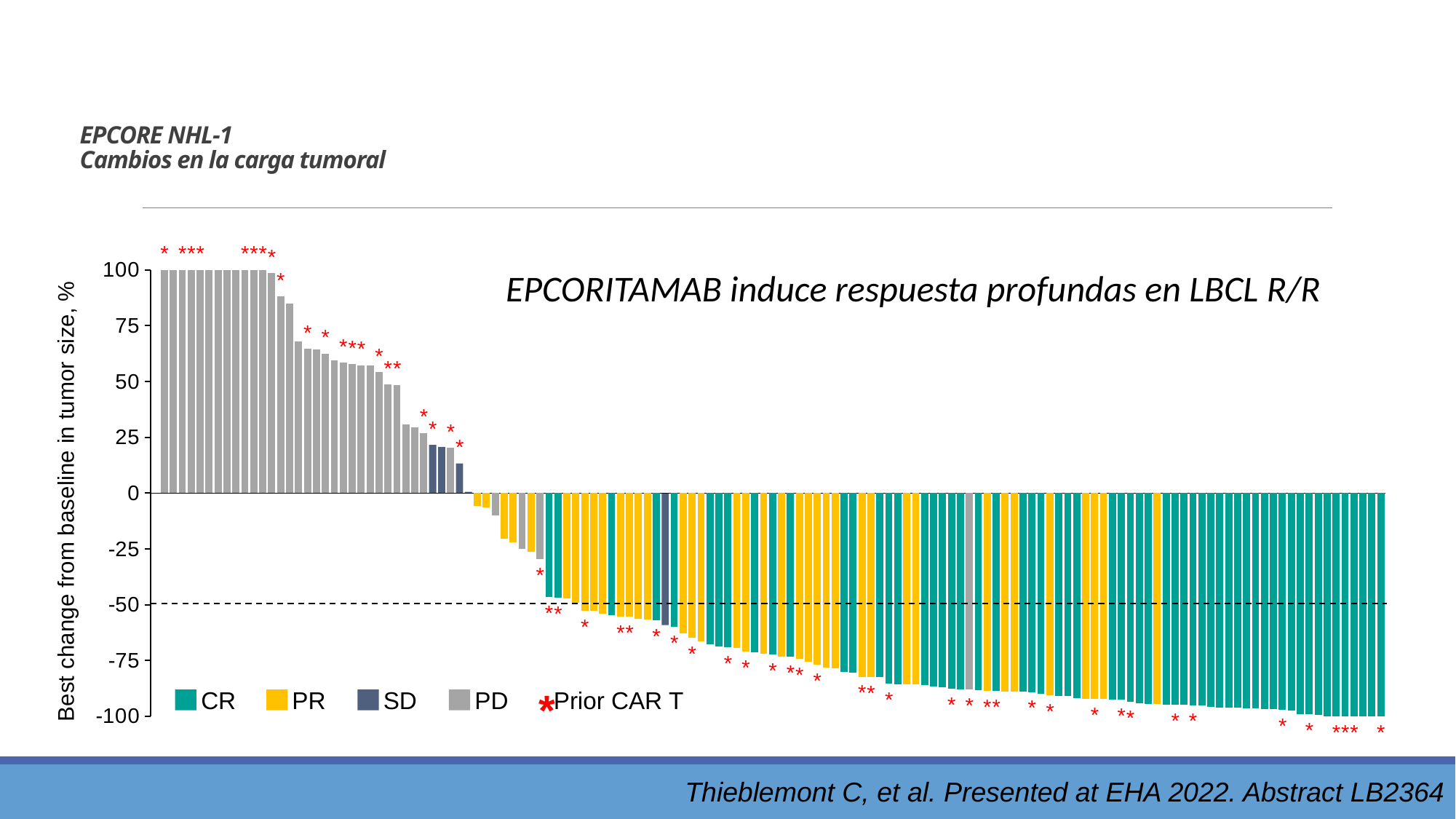
At what y-axis value is the horizontal dashed line drawn? -50 What does the red asterisk in the legend denote? Prior CAR T What is the label of the y axis? Best change from baseline in tumor size, % What value do the lowest bars at the right of the chart reach? -100 How many response categories (colour groups) does the legend list? 4 Do the bar values rise or fall moving from left to right along the x axis? fall Is the value of the leftmost bar greater or less than 75? greater Which response category do the bars with the largest decreases at the right end of the chart belong to? CR Is the value of the rightmost bar greater or less than -50? less What kind of chart is shown on the slide? bar chart What value do the tallest bars at the left of the chart reach? 100